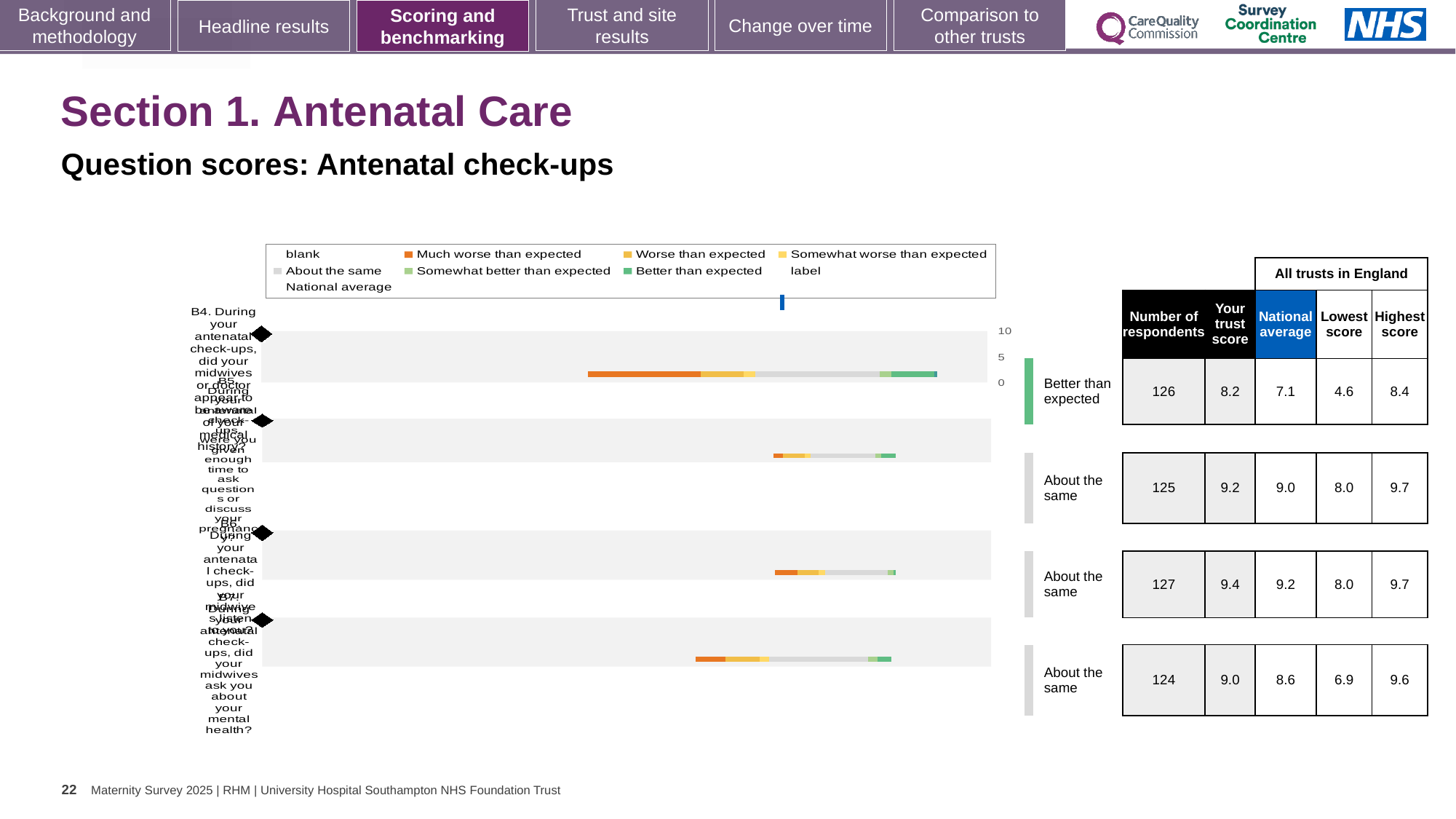
In the table beside the chart, what is the national average for the first row (B4)? 7.1 In the table beside the chart, what is the number of respondents for the first row (B4)? 126 What colour does the legend use for 'Much worse than expected'? orange In the table beside the chart, which is larger for the first row (B4): your trust score or the national average? your trust score In the table beside the chart, which row has the highest 'Your trust score'? the third row (B6), 9.4 How many question bars (B4 to B7) are plotted in the chart? 4 How many of the four question bars are labelled 'About the same'? 3 What colour does the legend use for 'Better than expected'? green What is the benchmark label shown beside the first bar (B4)? Better than expected In the table beside the chart, what is the difference between your trust score and the national average for the first row (B4)? 1.1 In the table beside the chart, what is 'Your trust score' for the first row (B4)? 8.2 What kind of chart is shown on the slide? bar chart